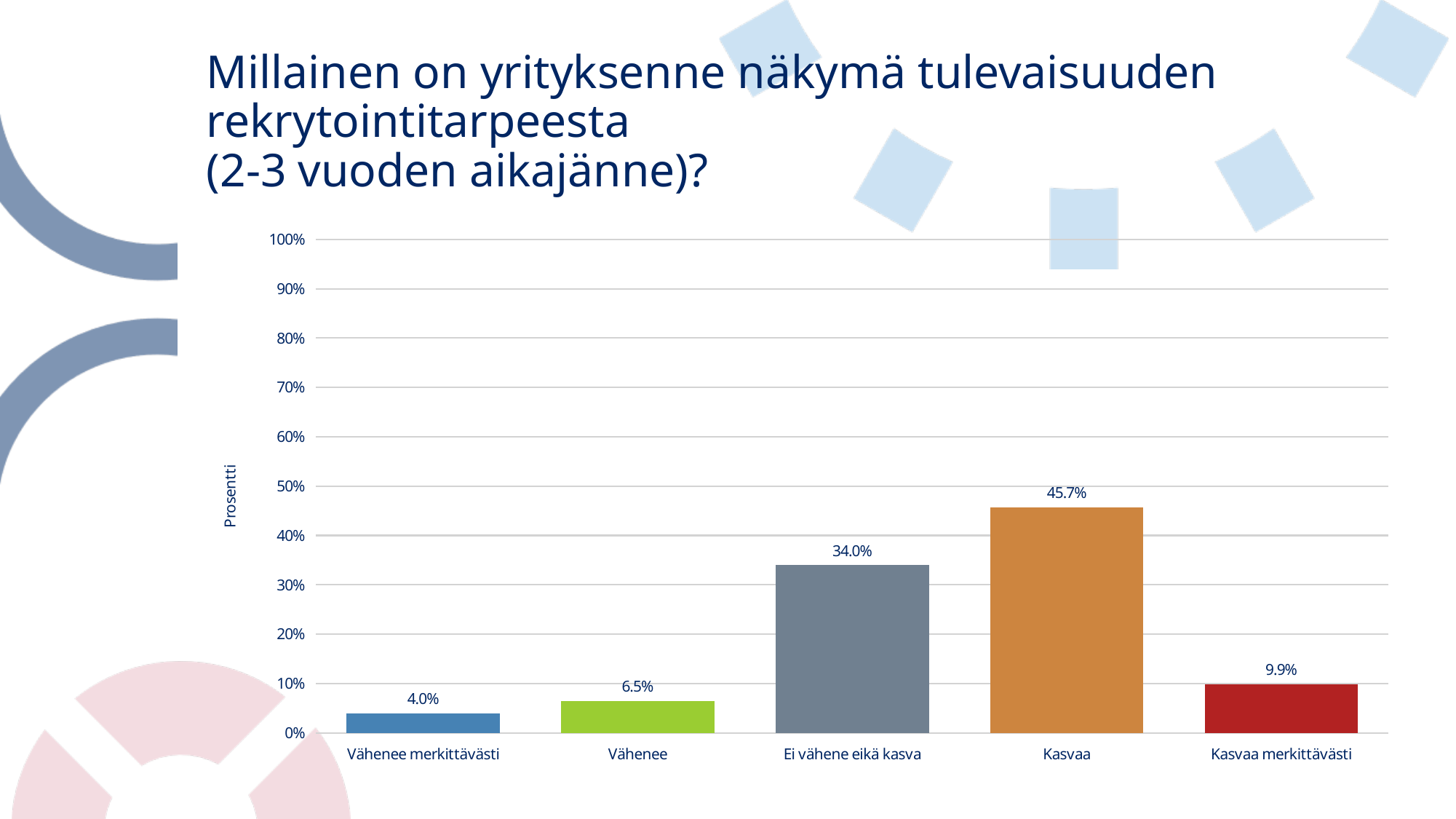
Which is larger, the value for Vähenee or the value for Kasvaa merkittävästi? Kasvaa merkittävästi What kind of chart is shown on the slide? bar chart What is the value for Kasvaa? 45.7% What is the difference between the values for Kasvaa and Ei vähene eikä kasva? 11.7% What is the value for Ei vähene eikä kasva? 34.0% Is the value for Ei vähene eikä kasva greater or less than 30%? greater How many categories are shown on the x axis? 5 What is the value for Kasvaa merkittävästi? 9.9% Which category has the lowest value? Vähenee merkittävästi What is the value for Vähenee merkittävästi? 4.0% Which category has the highest value? Kasvaa What is the label of the y axis? Prosentti